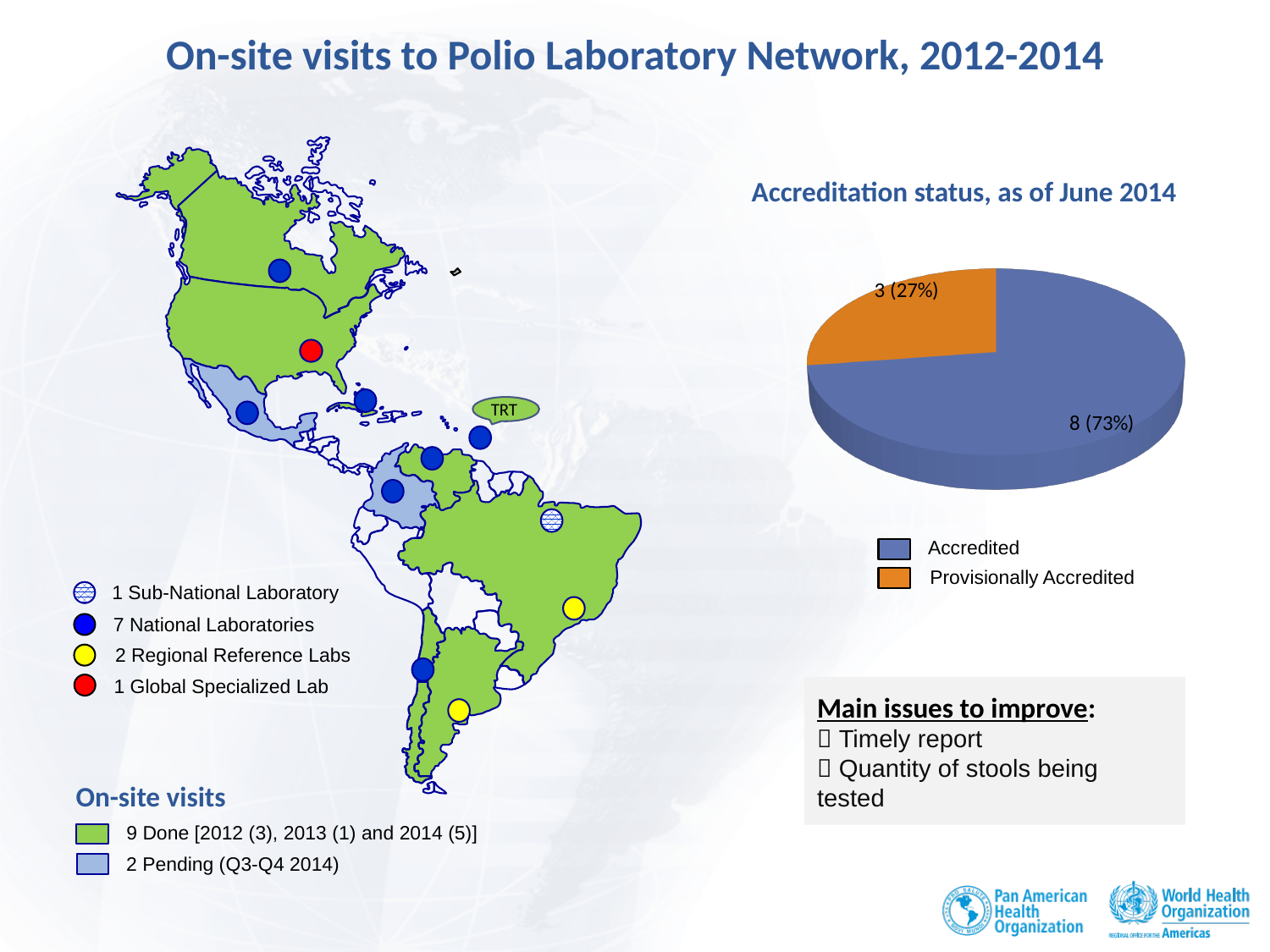
How many slices does the pie chart have? 2 Which category in the pie chart has the smallest slice? Provisionally Accredited What kind of chart is shown under "Accreditation status, as of June 2014"? pie chart What share of the pie chart does the Accredited slice represent? 73% In the pie chart, is the Accredited count larger or smaller than the Provisionally Accredited count? larger Which category in the pie chart has the largest slice? Accredited What colour is the Provisionally Accredited slice in the pie chart? orange In the pie chart, what is the difference between the number of Accredited and Provisionally Accredited laboratories? 5 In the pie chart, how many laboratories are Provisionally Accredited? 3 What share of the pie chart does the Provisionally Accredited slice represent? 27% How many entries does the pie chart's legend list? 2 In the pie chart, how many laboratories are Accredited? 8